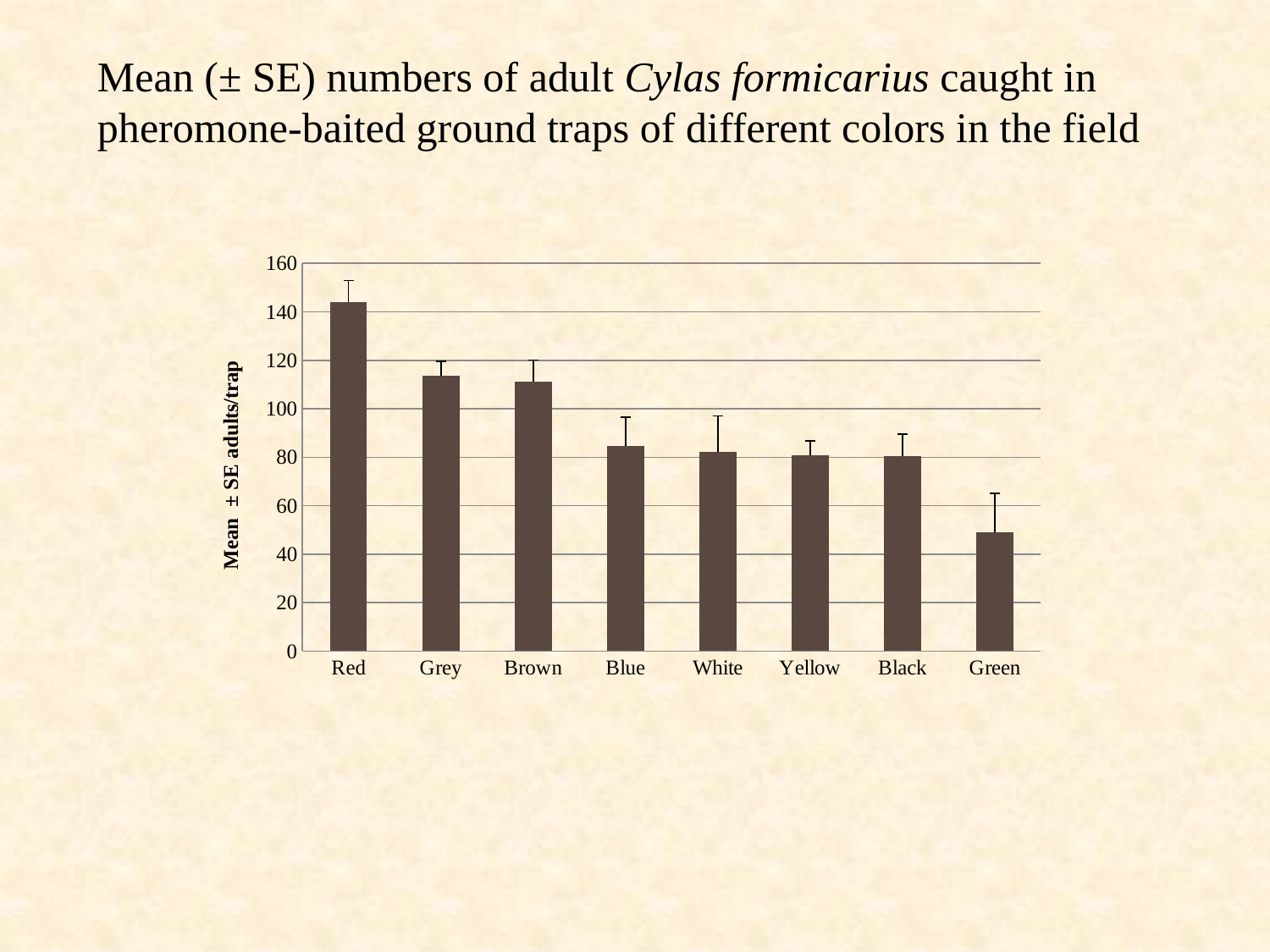
Which has a larger value, Red or Grey? Red Is the value for Grey greater or less than 100? greater Is the value for Green greater or less than 60? less What kind of chart is shown on the slide? bar chart Is the value for Blue greater or less than 100? less Which trap color has the highest mean number of adults per trap? Red Do the bar values generally rise or fall from left to right along the x axis? fall Which trap color has the lowest mean number of adults per trap? Green How many trap colors are shown on the x axis of the chart? 8 Which has a larger value, Brown or Blue? Brown